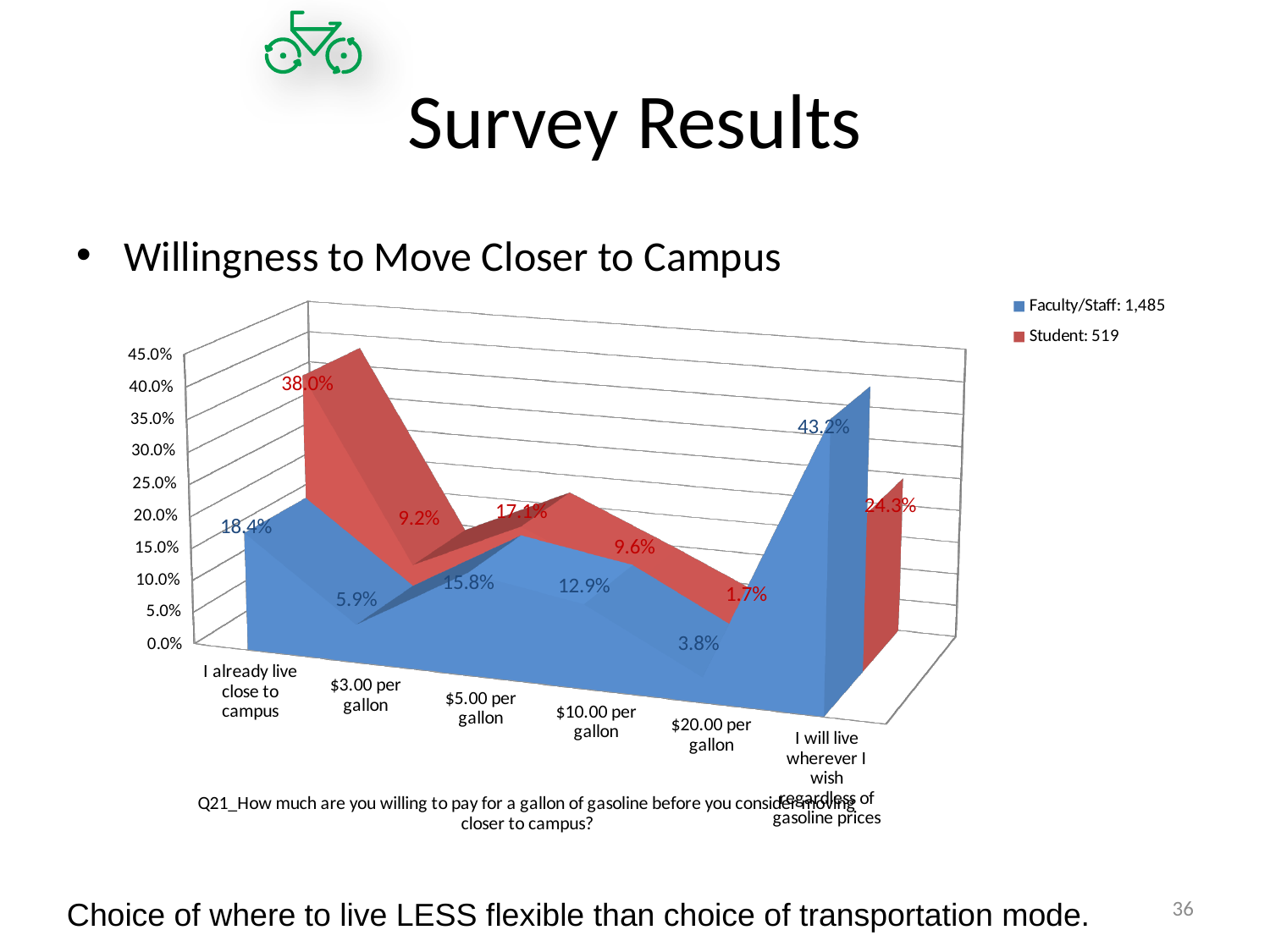
How many series does the legend list? 2 Which series is shown in red in the legend? Student: 519 Which category has the lowest Student value? $20.00 per gallon What kind of chart is shown on the slide? Area chart What is the difference between the Student and Faculty/Staff values for "I already live close to campus"? 19.6% How many categories are shown along the x axis? 6 For "$10.00 per gallon", which series has the larger value, Faculty/Staff or Student? Faculty/Staff What is the Student value for "I already live close to campus"? 38.0% What is the Faculty/Staff value for "I will live wherever I wish regardless of gasoline prices"? 43.2% Which category has the highest Faculty/Staff value? I will live wherever I wish regardless of gasoline prices What is the Faculty/Staff value for "$20.00 per gallon"? 3.8% What is the Student value for "$5.00 per gallon"? 17.1%